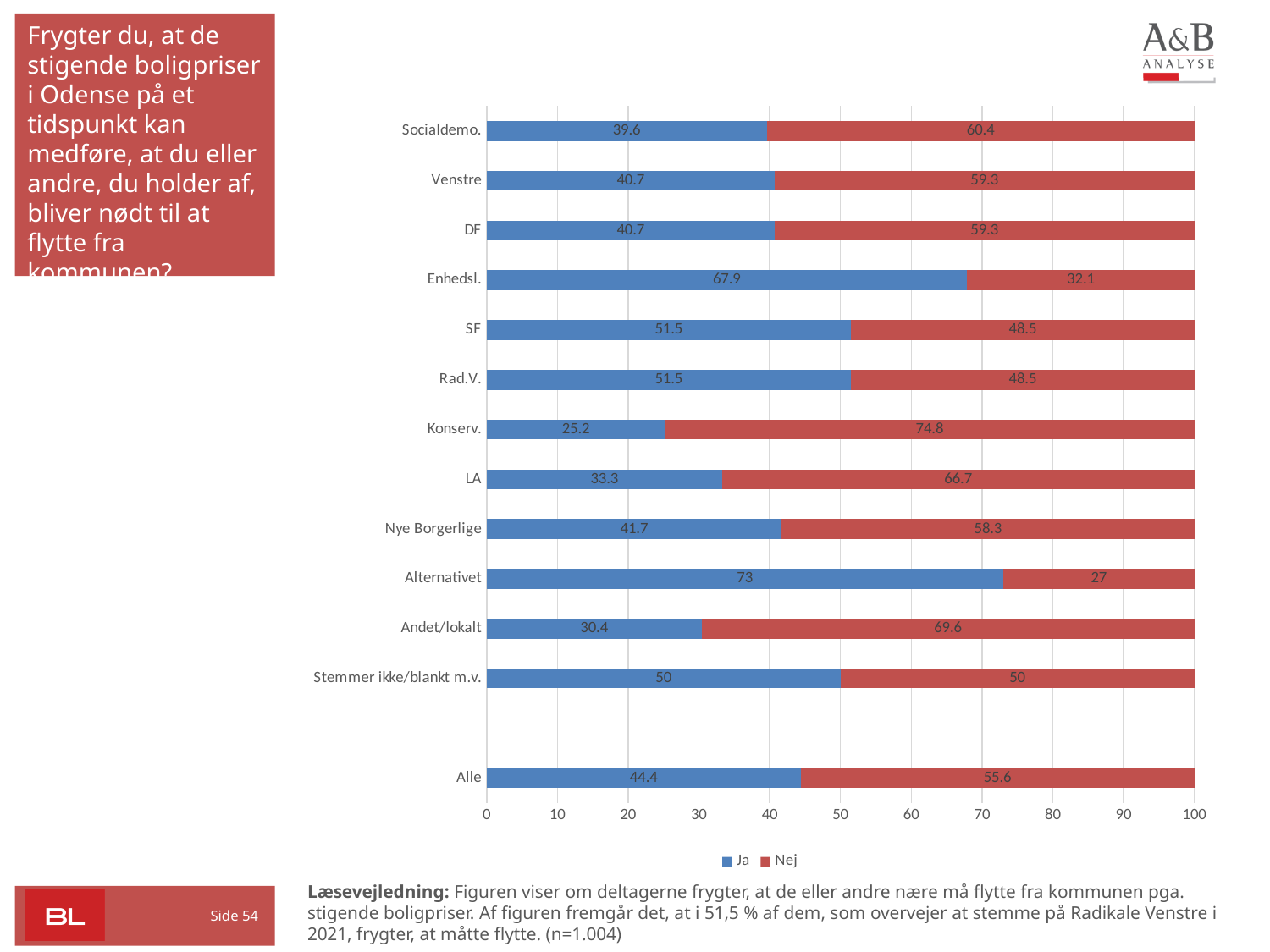
What is the "Ja" value for Enhedsl.? 67.9 What is the difference between the "Nej" value for LA and the "Nej" value for Socialdemo.? 6.3 Which category has the lowest "Ja" value? Konserv. What is the "Nej" value for Konserv.? 74.8 What is the total of the stacked bar for Stemmer ikke/blankt m.v.? 100 What is the "Ja" value for Alle? 44.4 Which category has the highest "Ja" value? Alternativet Which colour represents the "Nej" series in the chart? Red Which is larger: the "Ja" value for Nye Borgerlige or the "Ja" value for Andet/lokalt? Nye Borgerlige What kind of chart is shown on the slide? Stacked bar chart How many series does the legend list? 2 How many categories are shown on the y axis of the chart? 13